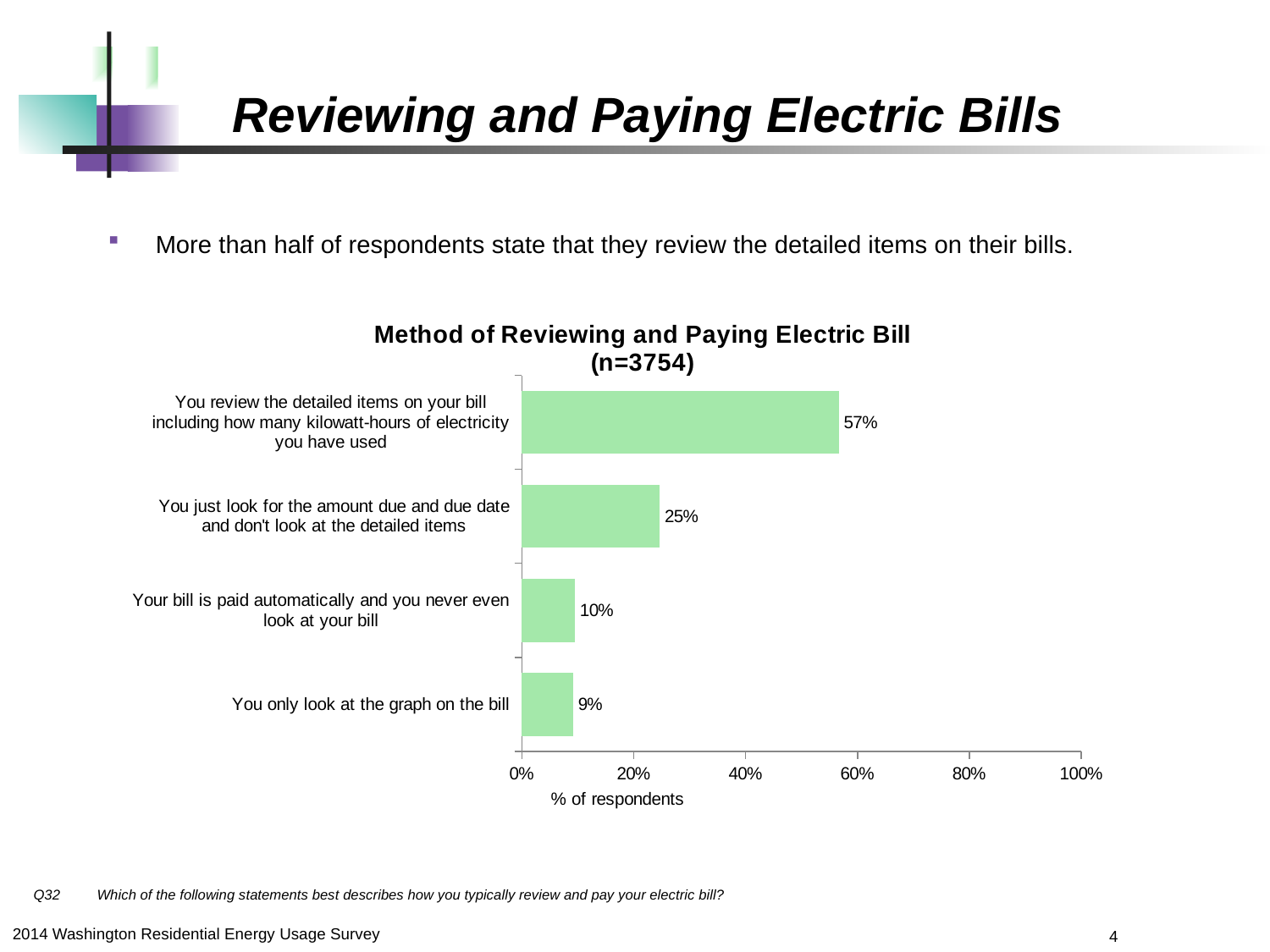
What is the sample size (n) shown in the chart title? 3754 Which is larger: the percentage of respondents whose bill is paid automatically and never look at it, or the percentage who only look at the graph on the bill? Your bill is paid automatically and you never even look at your bill Which method of reviewing and paying the electric bill has the highest percentage of respondents? You review the detailed items on your bill including how many kilowatt-hours of electricity you have used What type of chart is used to show the method of reviewing and paying the electric bill? Bar chart How many categories (methods of reviewing and paying the bill) are shown in the chart? 4 What is the difference in percentage points between respondents who review the detailed items on their bill and those who just look for the amount due and due date? 32 What percentage of respondents only look at the graph on the bill? 9% Is the value for respondents who just look for the amount due and due date greater or less than 40%? less What percentage of respondents just look for the amount due and due date and don't look at the detailed items? 25% What percentage of respondents review the detailed items on their bill including how many kilowatt-hours of electricity they have used? 57% What percentage of respondents say their bill is paid automatically and they never even look at their bill? 10% Which method of reviewing and paying the electric bill has the lowest percentage of respondents? You only look at the graph on the bill